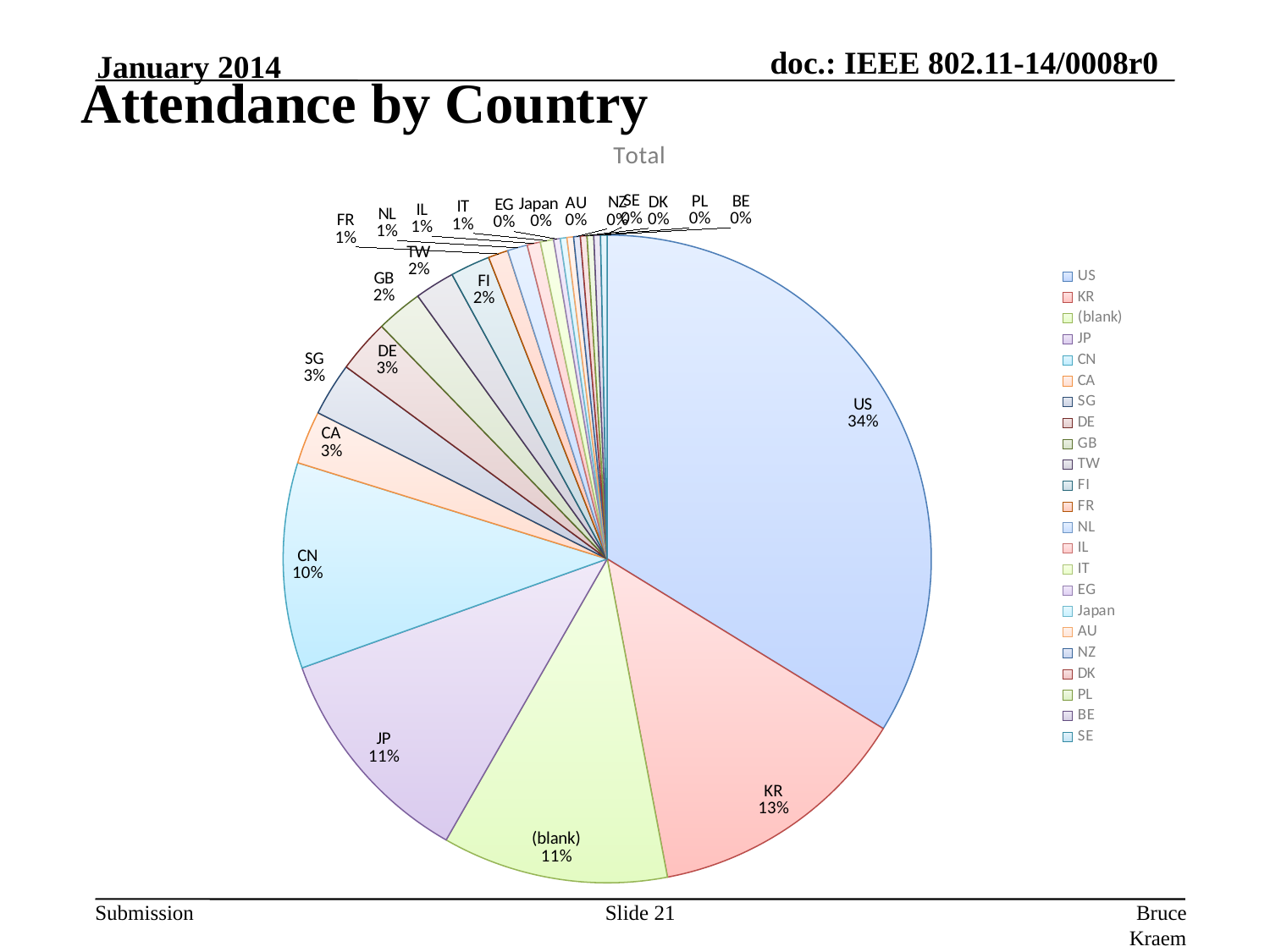
Which country has the largest share of attendance? US What share of attendance does JP have? 11% What is the title of the chart? Total What share of attendance does US have? 34% What share of attendance does CN have? 10% What is the difference in percentage points between the US share and the KR share? 21 How many entries does the legend list? 23 Which has a larger share, KR or CN? KR What kind of chart is shown on the slide? pie chart